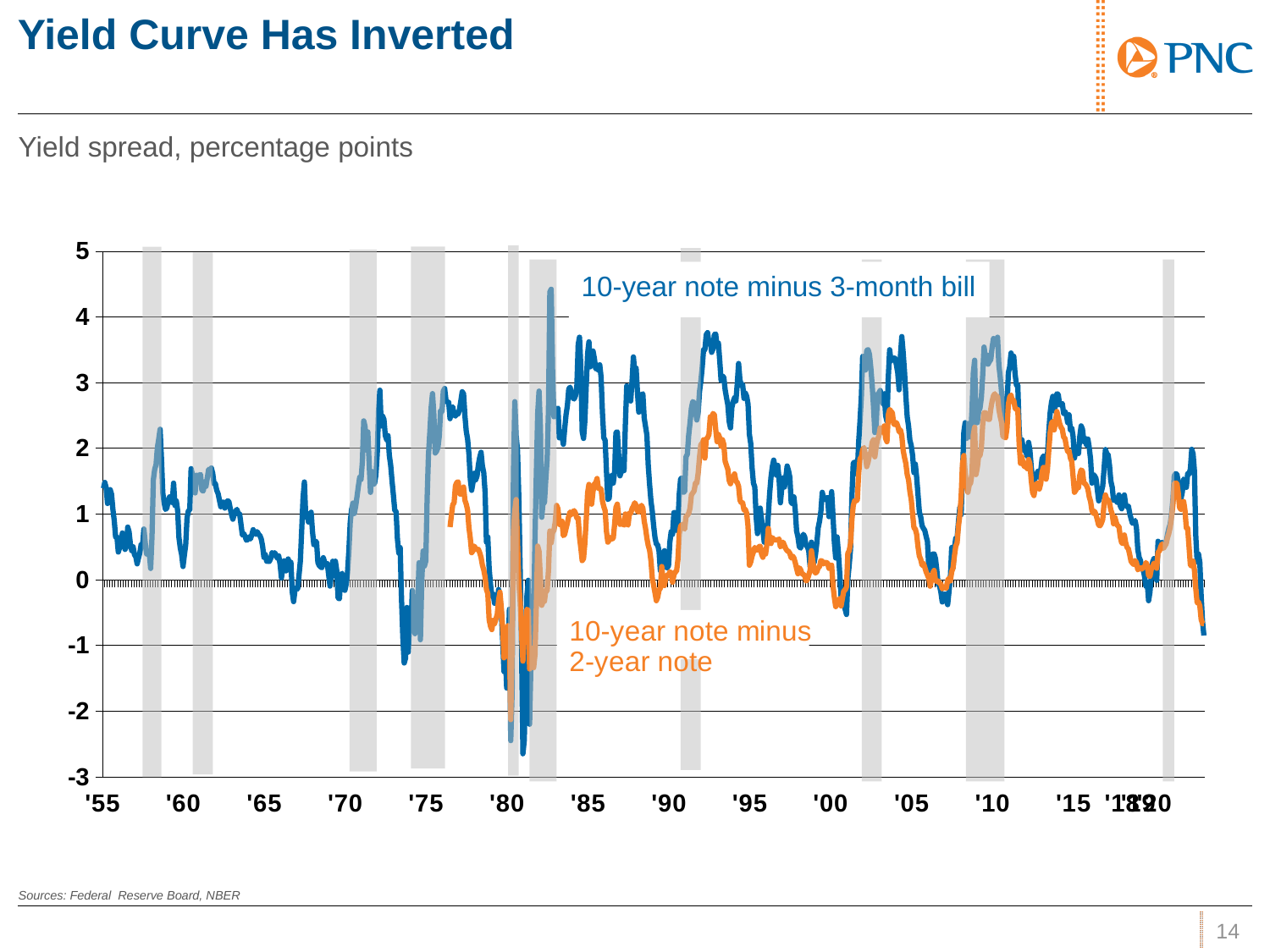
Does the 10-year note minus 3-month bill series rise or fall between 2018 and the end of the chart in 2020? fall How many data series are plotted on the chart? 2 Is the value of the 10-year note minus 3-month bill series at the far right end of the chart (2020) greater or less than 0? less Around 1983, which series has the higher value: 10-year note minus 3-month bill or 10-year note minus 2-year note? 10-year note minus 3-month bill Is the peak value of the 10-year note minus 3-month bill series around 1992 greater or less than 3? greater Is the value of the 10-year note minus 3-month bill series at its peak around 1983 greater or less than 4? greater What is the title of the slide containing the chart? Yield Curve Has Inverted What kind of chart is shown on the slide? line chart What unit is the yield spread measured in, according to the chart subtitle? percentage points